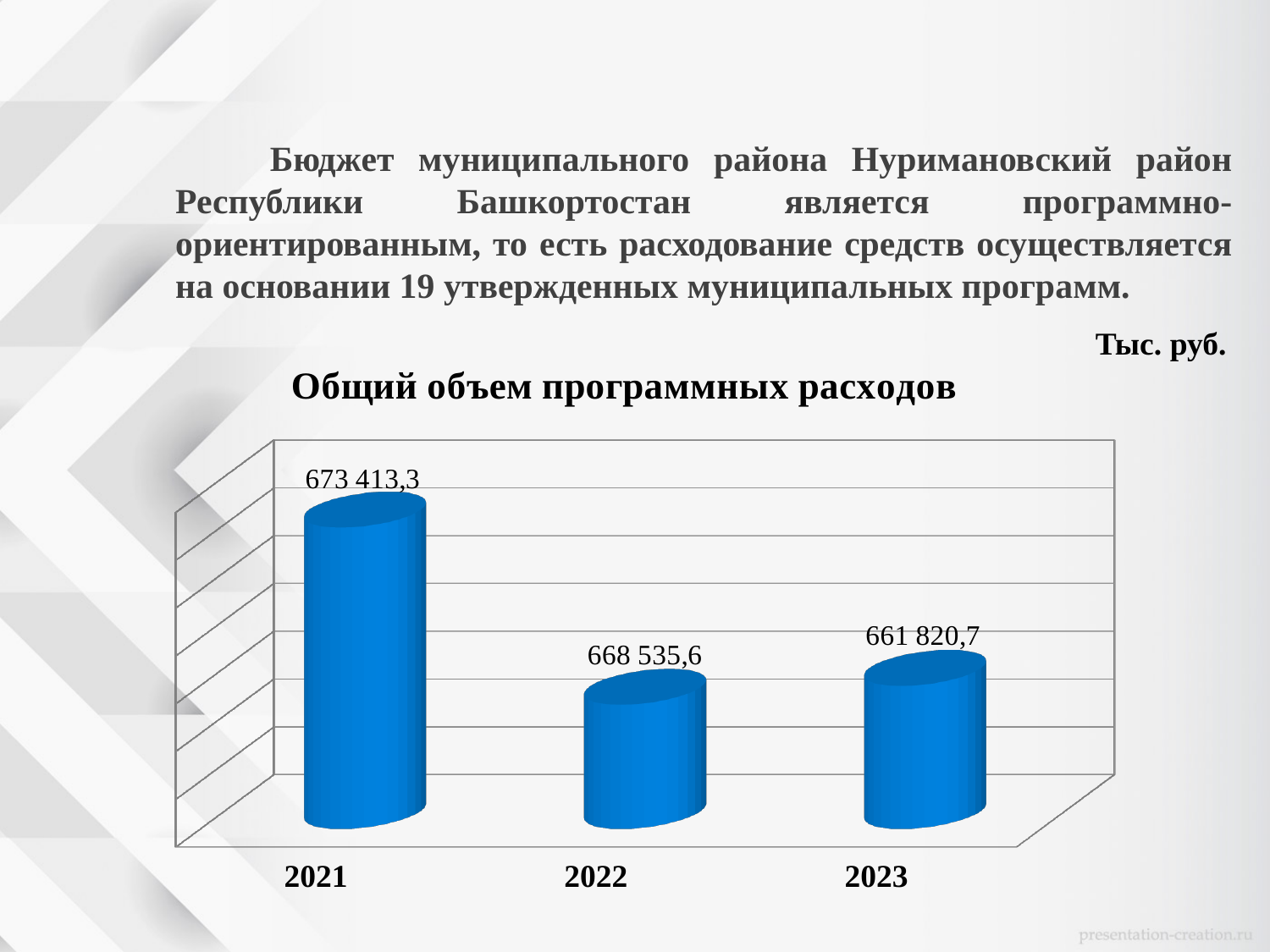
What is the difference between the values for 2021 and 2022? 4 877,7 What is the value for 2021 in the chart "Общий объем программных расходов"? 673 413,3 What is the difference between the values for 2021 and 2023? 11 592,6 How many years are shown on the x axis of the chart? 3 What is the difference between the values for 2022 and 2023? 6 714,9 Which year has the highest value in the chart? 2021 What is the value for 2023 in the chart? 661 820,7 What kind of chart is shown on the slide? Bar chart Do the values rise or fall from 2021 to 2023? Fall What is the value for 2022 in the chart? 668 535,6